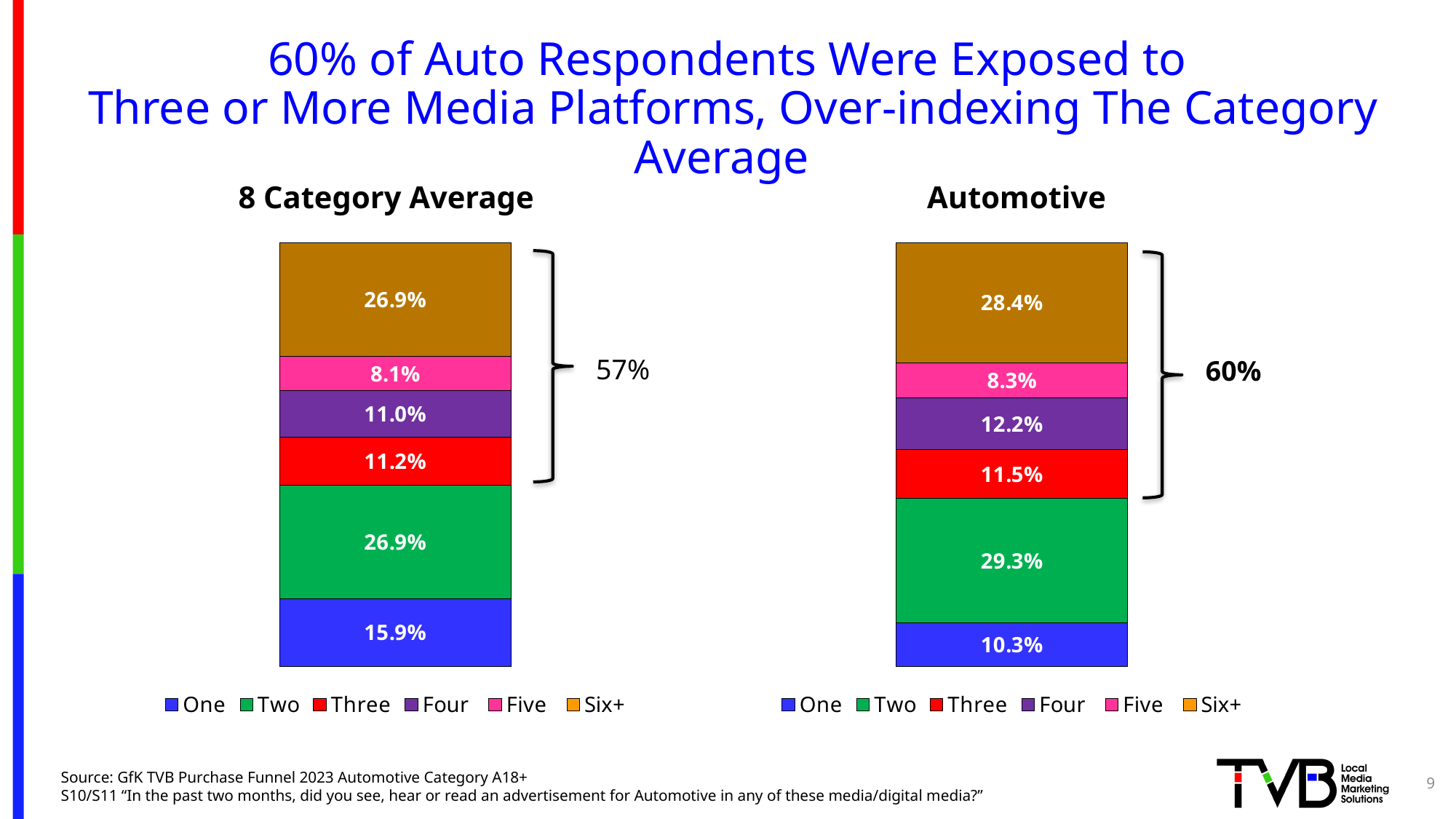
In the 8 Category Average chart, what is the value for the Two segment? 26.9% How many segments make up the stacked bar in the 8 Category Average chart? 6 In the 8 Category Average chart, what is the difference between the Six+ and Five segments? 18.8% In the 8 Category Average chart, which segment has the smallest value? Five What type of chart is used for the Automotive data? Stacked bar chart In the Automotive chart, what is the difference between the Two and One segments? 19.0% In the Automotive chart, what is the value for the One segment? 10.3% Which is larger: the Four segment in the 8 Category Average chart or the Four segment in the Automotive chart? Automotive According to the bracket label on the Automotive chart, what share of respondents were exposed to three or more platforms? 60% In the Automotive chart, which segment has the largest value? Two How many entries does the legend of the Automotive chart list? 6 In the Automotive chart, what is the value for the Six+ segment? 28.4%